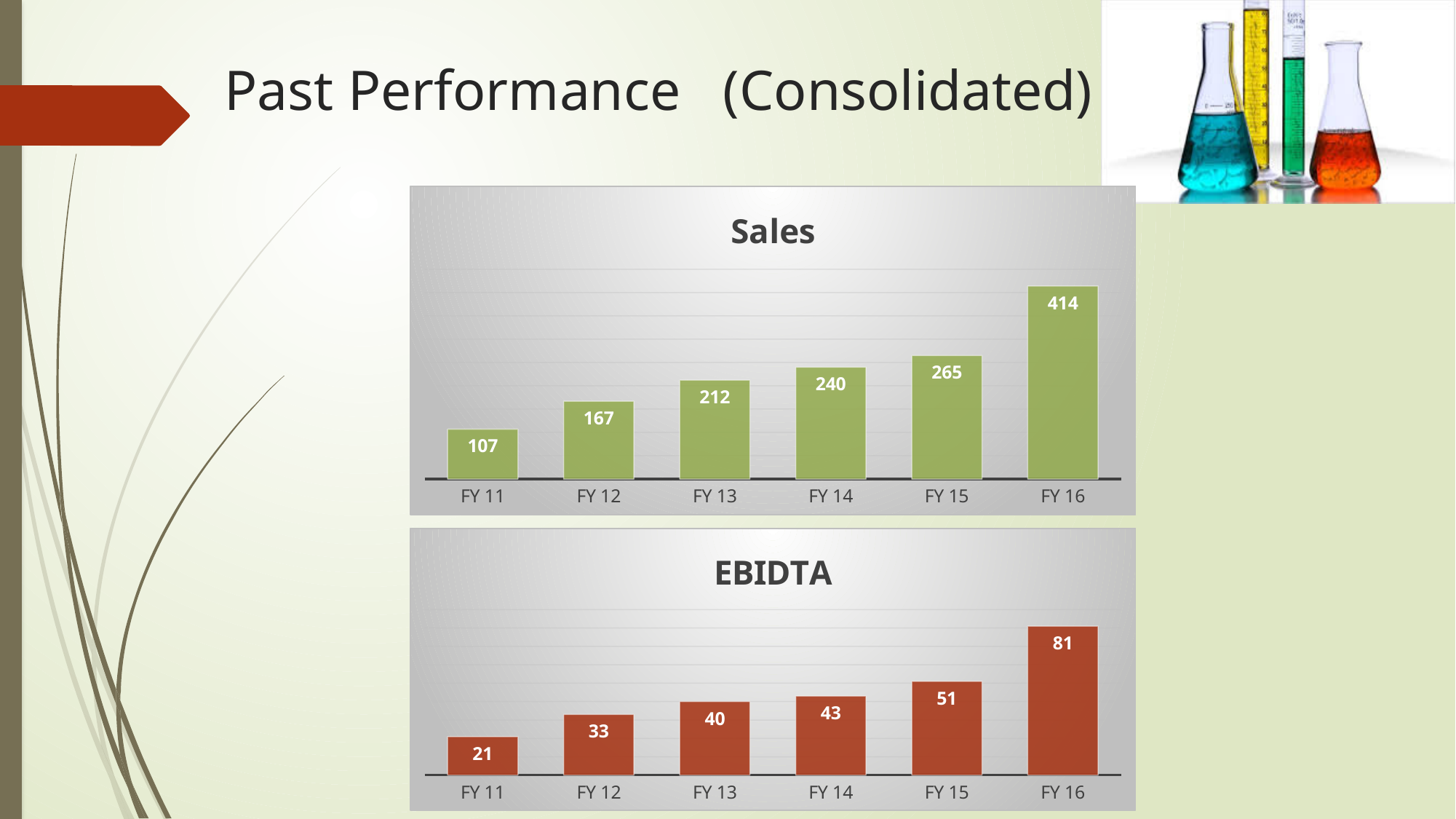
What colour are the bars in the Sales chart? Green What is the title of the lower chart on the slide? EBIDTA In the Sales chart, what is the difference between the FY 16 and FY 15 values? 149 In the EBIDTA chart, what is the difference between the FY 12 and FY 11 values? 12 In the Sales chart, what is the value for FY 13? 212 In the EBIDTA chart, do the values rise or fall from FY 11 to FY 16? Rise How many fiscal years are shown in the EBIDTA chart? 6 In the EBIDTA chart, which fiscal year has the lowest value? FY 11 What kind of chart is the Sales chart? Bar chart In the Sales chart, which is larger, the value for FY 12 or the value for FY 14? FY 14 In the Sales chart, which fiscal year has the highest value? FY 16 In the EBIDTA chart, what is the value for FY 15? 51